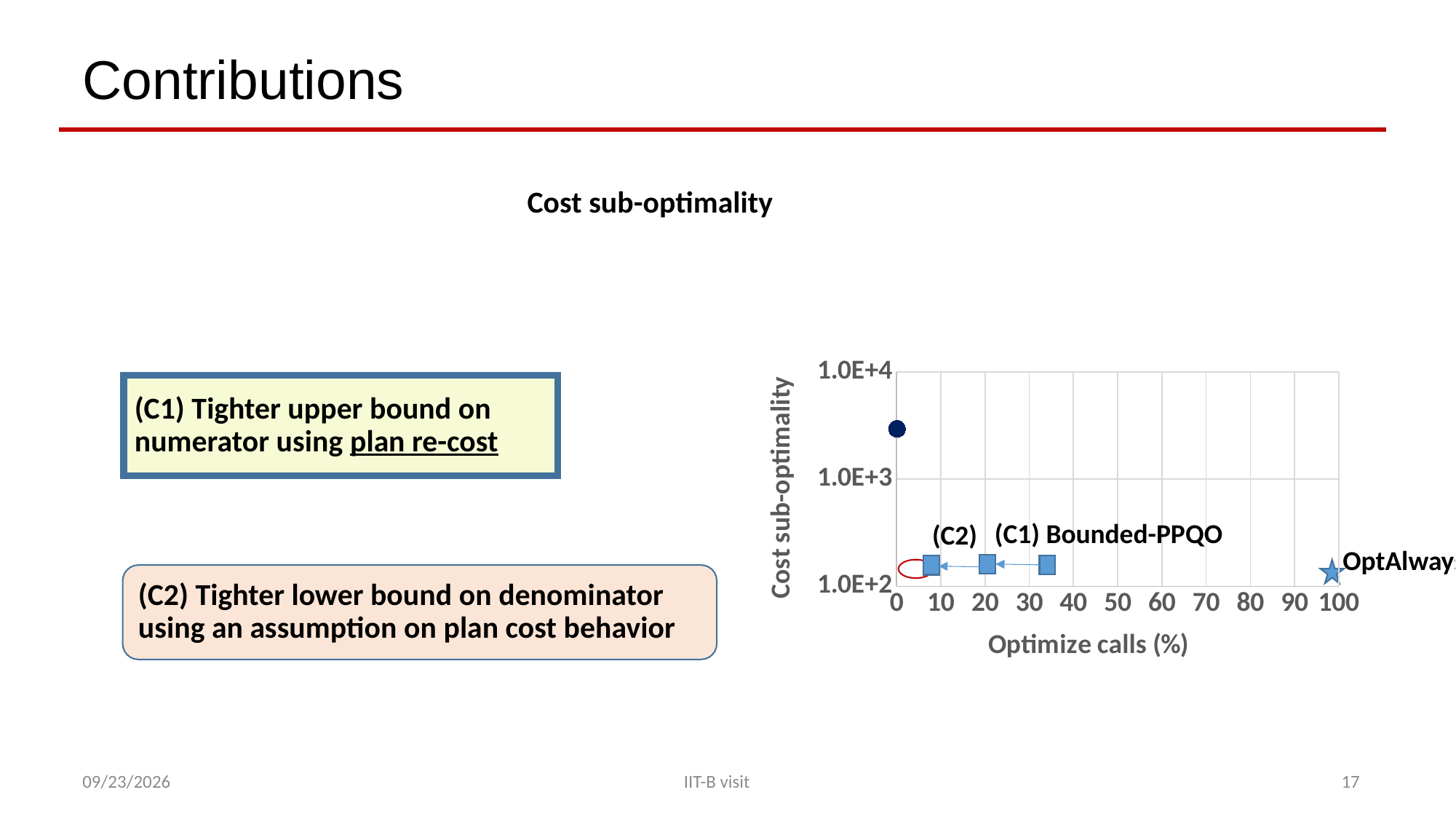
Is the cost sub-optimality of the dark circle point near 0% optimize calls greater or less than 1.0E+3? greater How many square markers are plotted on the chart? 3 What kind of chart is shown on the slide? scatter chart Is the optimize calls value of the OptAlways point greater or less than 90? greater Is the cost sub-optimality of the OptAlways point greater or less than 1.0E+3? less Which plotted point has the highest cost sub-optimality? the dark circle point near 0% optimize calls What is the title of the x axis of the chart? Optimize calls (%) Which point has the higher cost sub-optimality: the dark circle point or the OptAlways star? the dark circle point What is the highest value labelled on the y axis of the chart? 1.0E+4 Which labelled point has the highest optimize calls percentage? OptAlways What is the title of the y axis of the chart? Cost sub-optimality